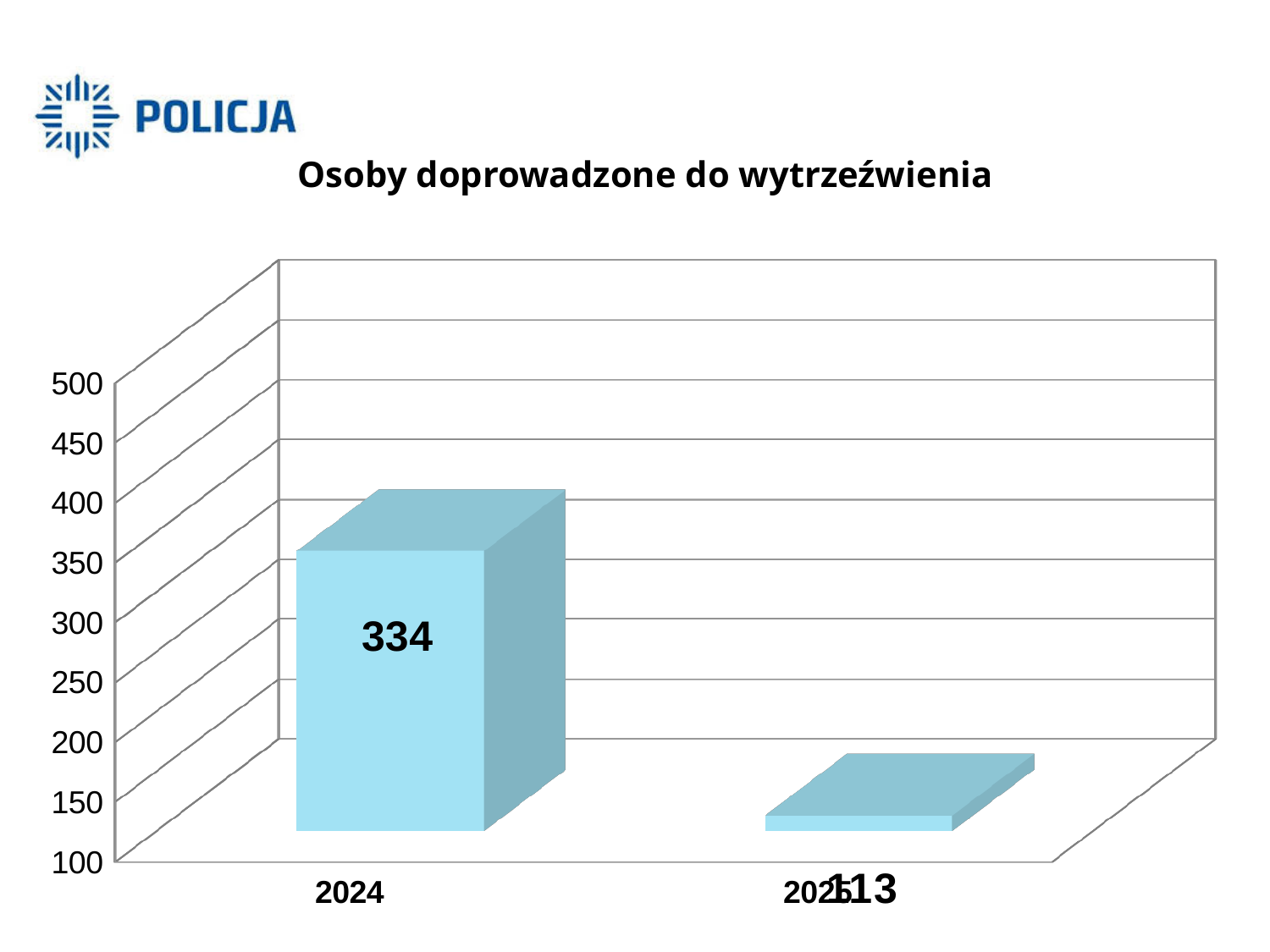
Do the values rise or fall from 2024 to 2025? fall What is the value for 2024? 334 Which year has the lowest value? 2025 What kind of chart is shown on the slide? bar chart What is the value shown for the right-hand bar (2025)? 113 Which is larger, the value for 2024 or the value for 2025? 2024 Is the value for 2024 greater or less than 300? greater Is the value for 2025 greater or less than 150? less How many categories are shown on the x axis? 2 What is the title of the chart? Osoby doprowadzone do wytrzeźwienia Which year has the highest value? 2024 What is the difference between the values for 2024 and 2025? 221